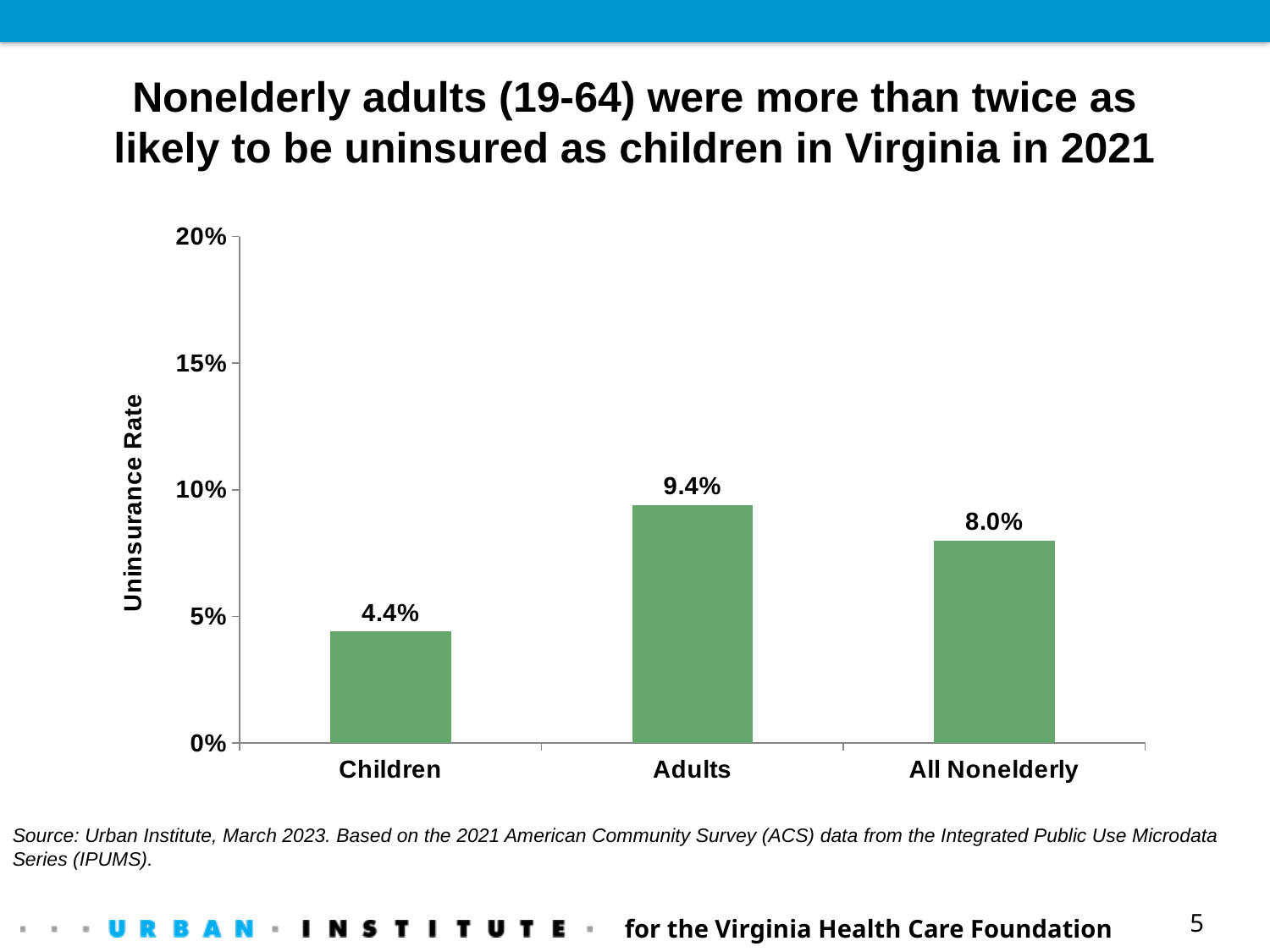
What is the uninsurance rate for Children? 4.4% How many categories are shown on the x axis? 3 What is the uninsurance rate for All Nonelderly? 8.0% What is the label of the y axis? Uninsurance Rate Which category has the lowest uninsurance rate? Children What kind of chart is shown on the slide? bar chart What is the uninsurance rate for Adults? 9.4% Which is larger, the uninsurance rate for All Nonelderly or for Children? All Nonelderly Is the uninsurance rate for Adults greater or less than 10%? less Which category has the highest uninsurance rate? Adults What is the difference between the uninsurance rate for Adults and for Children? 5.0% What is the difference between the uninsurance rate for Adults and for All Nonelderly? 1.4%